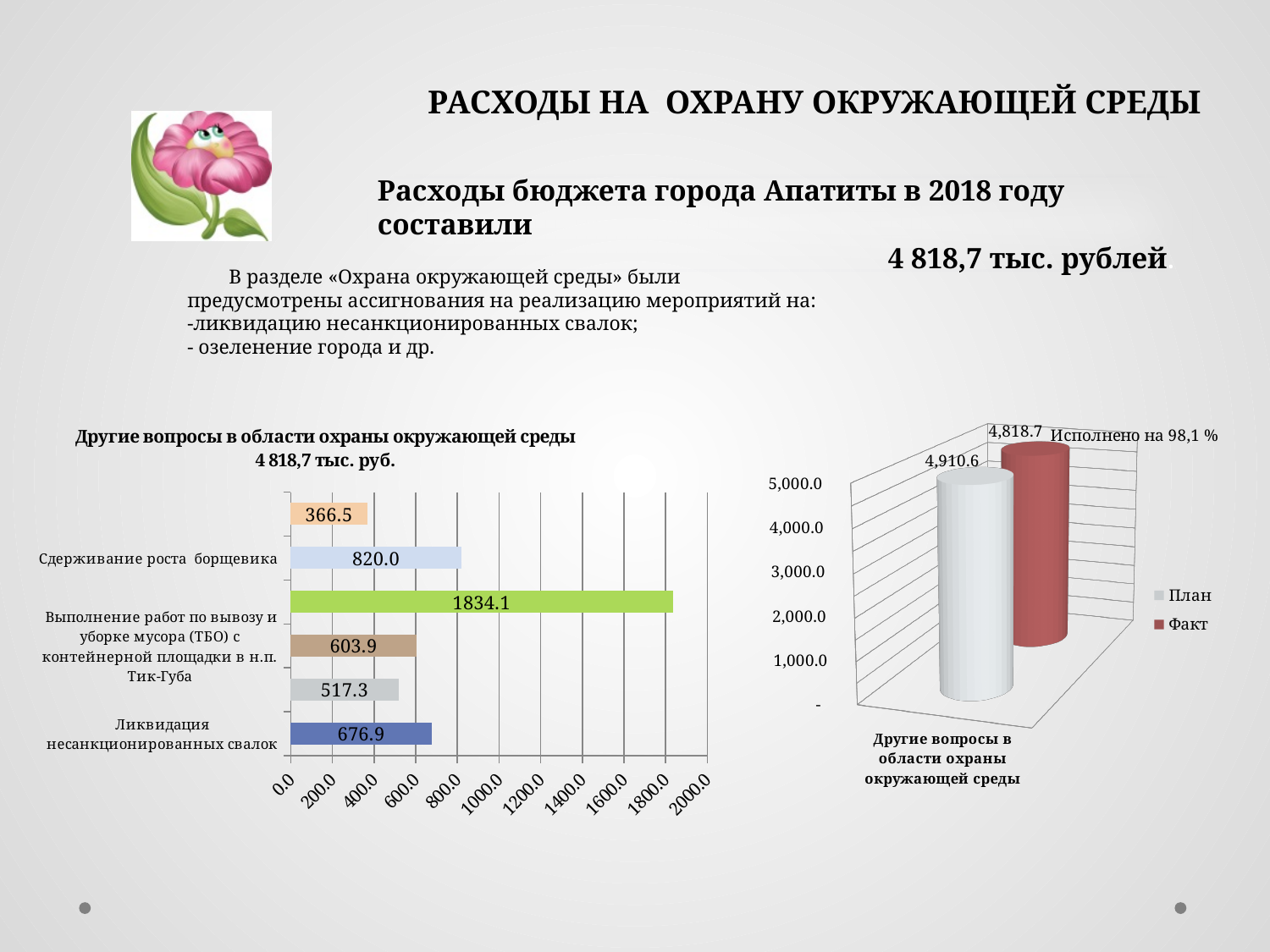
In the left chart, what is the difference between the values for Сдерживание роста борщевика and Ликвидация несанкционированных свалок? 143.1 How many bars are plotted in the left chart? 6 In the right chart, what is the value for План? 4,910.6 How many series does the legend of the right chart list? 2 What kind of chart is the left chart? bar chart In the left chart, what is the smallest value shown on any bar? 366.5 In the left chart, what is the value for Ликвидация несанкционированных свалок? 676.9 In the left chart, what is the value for Выполнение работ по вывозу и уборке мусора (ТБО) с контейнерной площадки в н.п. Тик-Губа? 603.9 In the left chart, which is larger: Сдерживание роста борщевика or Ликвидация несанкционированных свалок? Сдерживание роста борщевика In the left chart, what is the value for Сдерживание роста борщевика? 820.0 In the right chart, what is the difference between План and Факт? 91.9